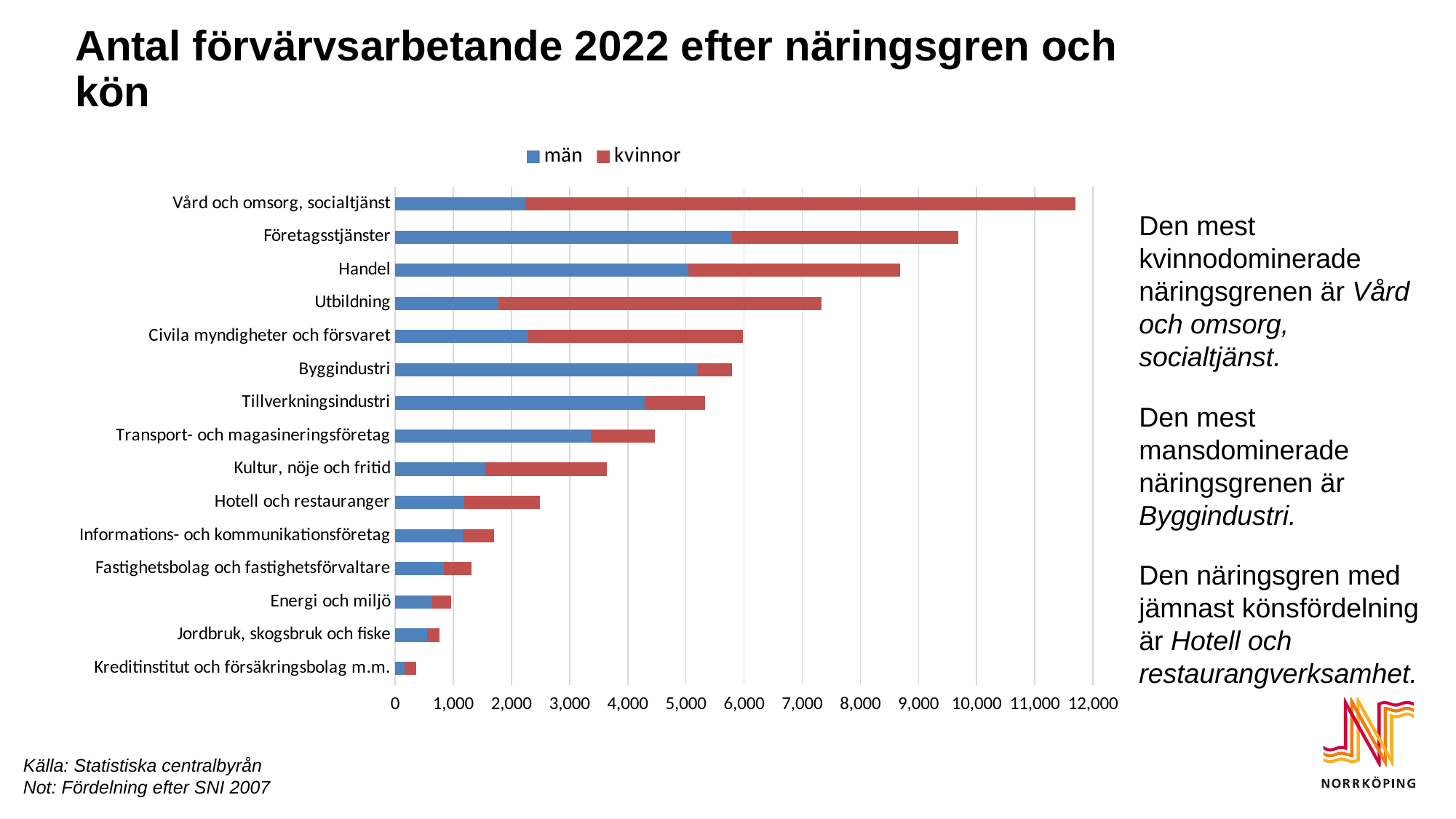
Is the total bar for Vård och omsorg, socialtjänst greater or less than 11,000? greater How many series does the legend list? 2 What kind of chart is shown on the slide? Stacked bar chart How many industry categories (näringsgrenar) are plotted in the chart? 15 Which has the longer män segment, Byggindustri or Utbildning? Byggindustri Which category has the longest total bar? Vård och omsorg, socialtjänst Which has the longer total bar, Handel or Utbildning? Handel Which colour represents kvinnor in the chart? Red Is the total bar for Utbildning greater or less than 7,000? greater Is the män segment for Företagstjänster greater or less than 5,000? greater Which category has the shortest total bar? Kreditinstitut och försäkringsbolag m.m.